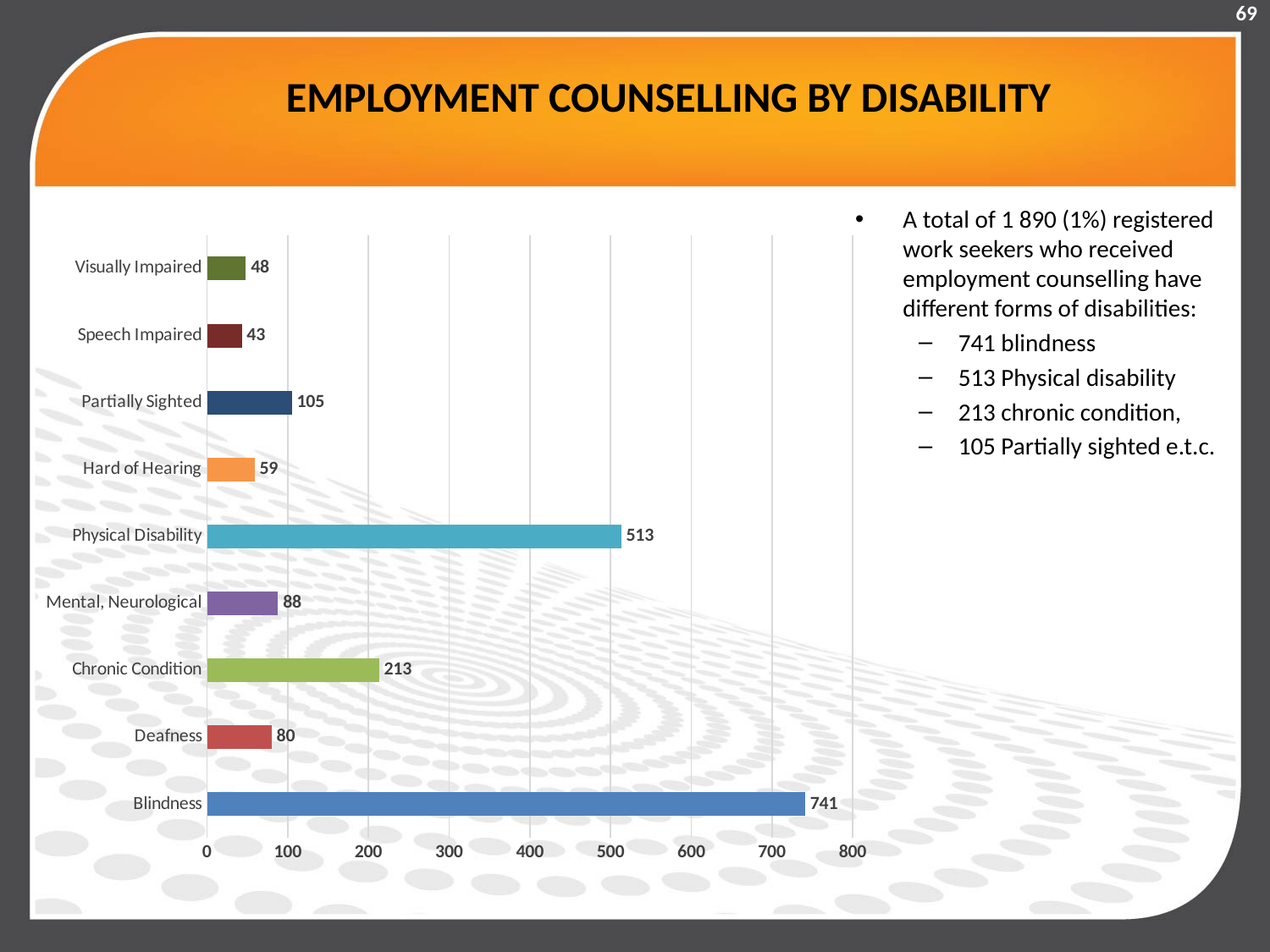
What is the value for Hard of Hearing? 59 What is the difference between the values for Blindness and Physical Disability? 228 Is the value for Mental, Neurological greater or less than 100? less What is the title of the slide containing the chart? EMPLOYMENT COUNSELLING BY DISABILITY Which category has the highest value? Blindness Which category has the lowest value? Speech Impaired What is the difference between the values for Deafness and Visually Impaired? 32 Which is larger, the value for Chronic Condition or the value for Partially Sighted? Chronic Condition How many categories are shown in the chart? 9 What kind of chart is shown on the slide? bar chart What is the value for Physical Disability? 513 What is the value for Blindness? 741